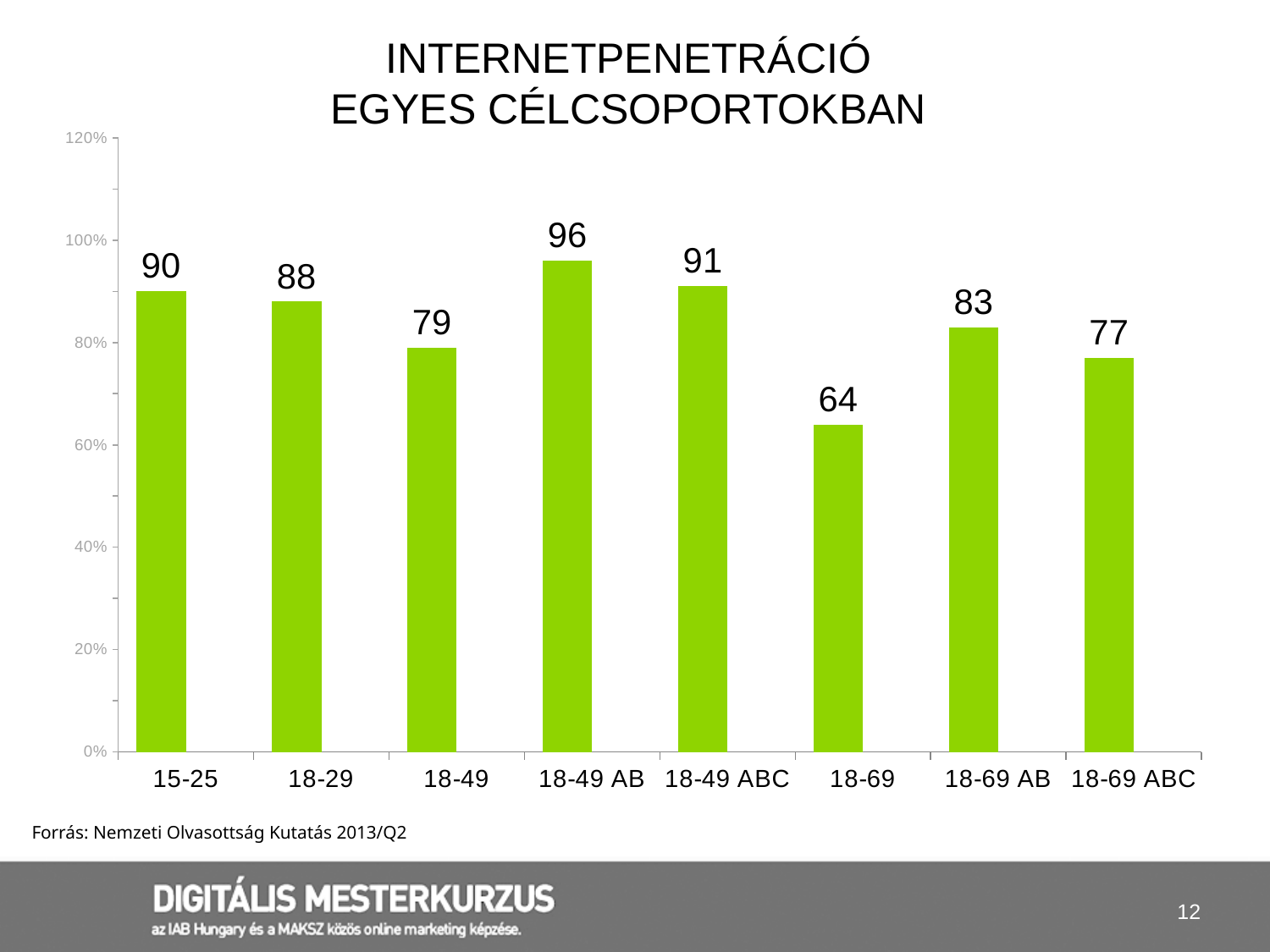
Is the value for 18-69 greater or less than 80%? less Which category has the lowest value? 18-69 How many categories are shown on the x axis? 8 What is the difference between the values for 18-49 AB and 18-69? 32 What kind of chart is shown on the slide? bar chart What is the value for the 18-69 AB category? 83 What is the value for the 15-25 category? 90 Which is larger, the value for 18-29 or the value for 18-69 ABC? 18-29 What is the difference between the values for 15-25 and 18-49? 11 What is the value for the 18-49 ABC category? 91 What is the title of the chart? INTERNETPENETRÁCIÓ EGYES CÉLCSOPORTOKBAN Which category has the highest value? 18-49 AB